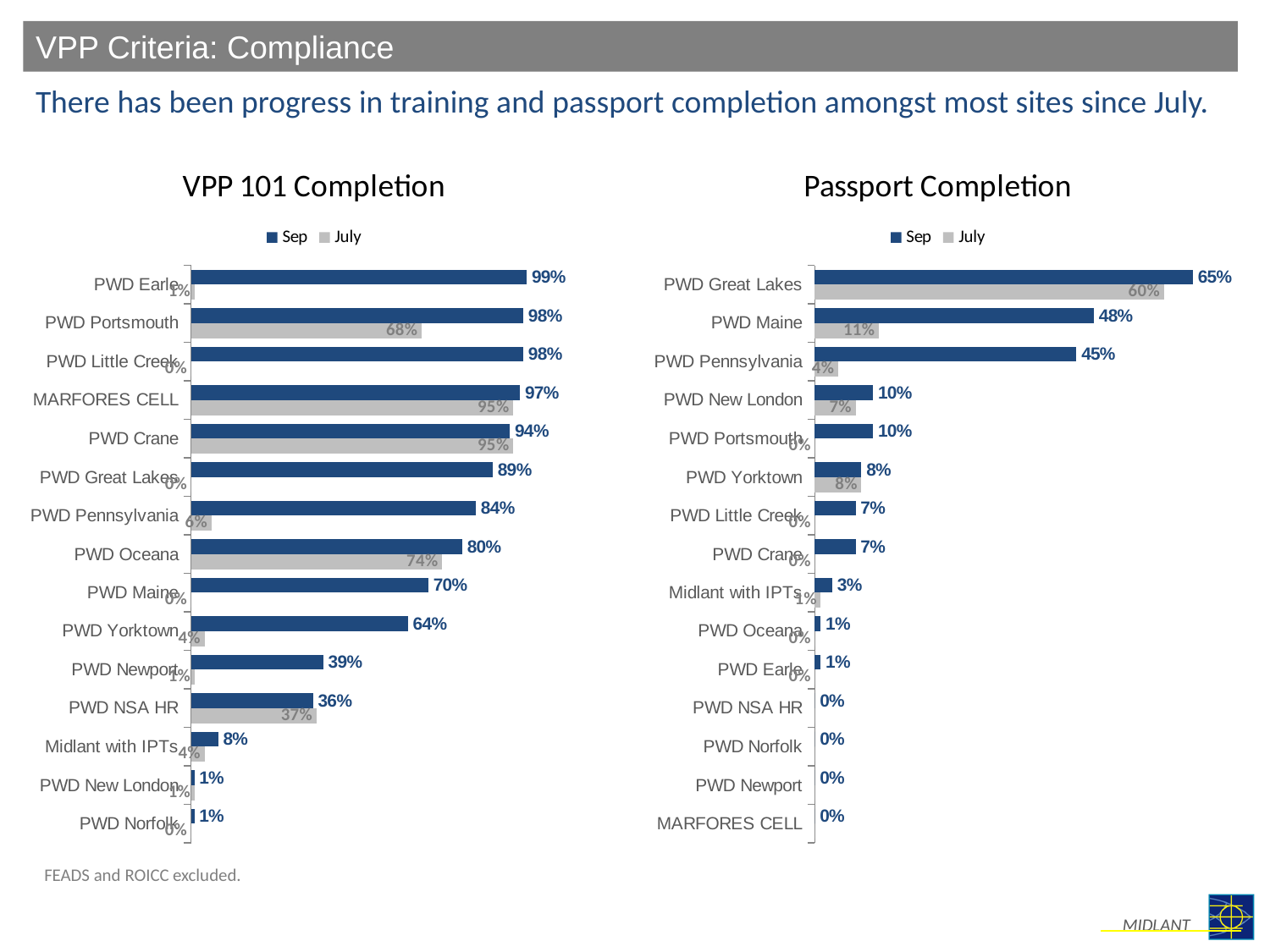
In the VPP 101 Completion chart, what is the difference between the Sep and July values for PWD Portsmouth? 30% In the VPP 101 Completion chart, what is the July value for PWD Oceana? 74% In the VPP 101 Completion chart, which is larger for PWD NSA HR, the Sep value or the July value? July In the VPP 101 Completion chart, which site has the highest Sep value? PWD Earle How many series does the legend of the Passport Completion chart list? 2 What type of chart is the VPP 101 Completion chart? Bar chart In the Passport Completion chart, what is the difference between the Sep and July values for PWD Pennsylvania? 41% In the Passport Completion chart, what is the July value for PWD Great Lakes? 60% In the Passport Completion chart, what is the Sep value for PWD Maine? 48% In the Passport Completion chart, which site has the highest Sep value? PWD Great Lakes In the VPP 101 Completion chart, how many sites are listed? 15 In the VPP 101 Completion chart, what is the Sep value for PWD Portsmouth? 98%